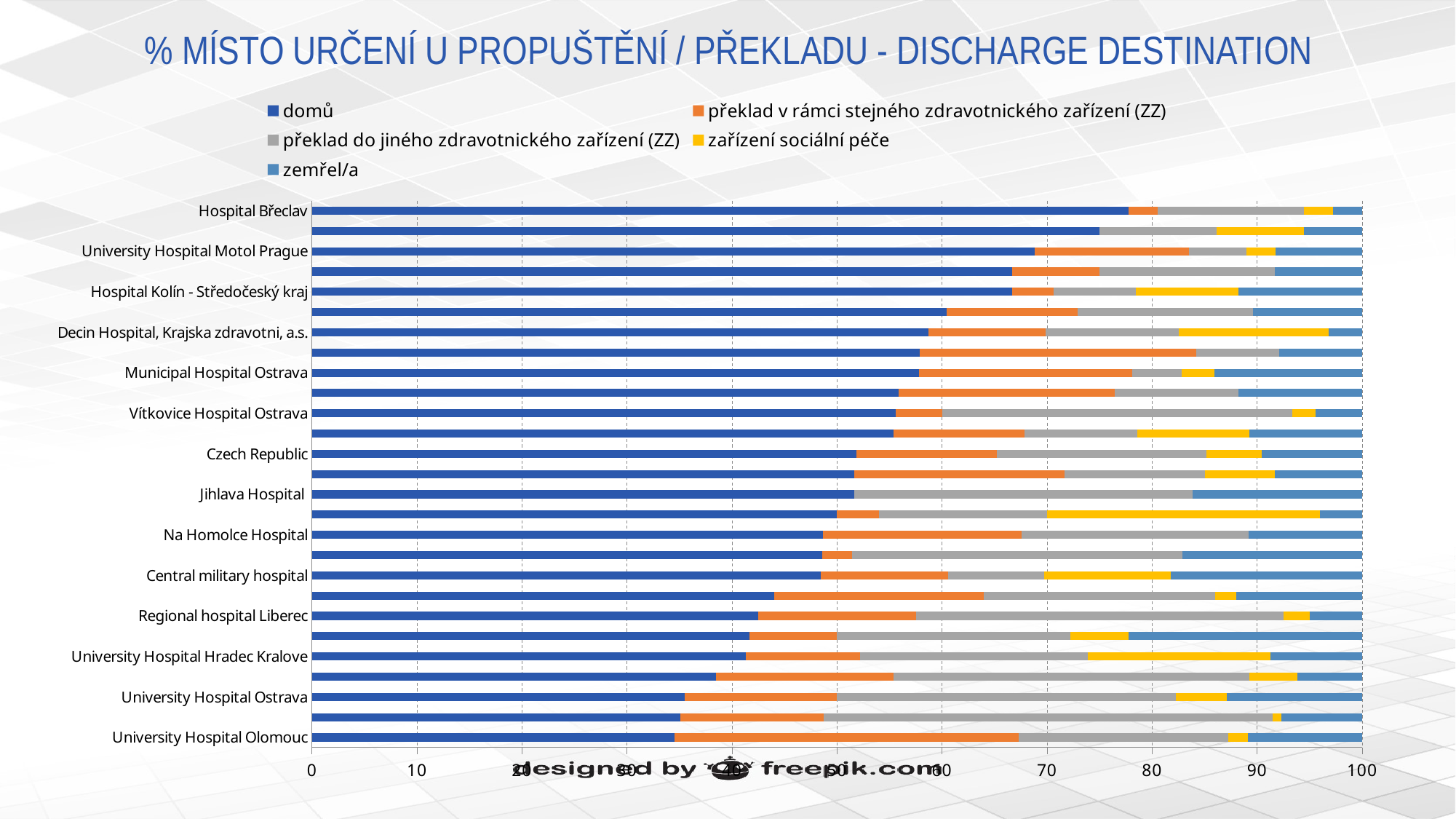
Is the 'domů' value for University Hospital Olomouc greater or less than 40? less What is the title of the chart? % MÍSTO URČENÍ U PROPUŠTĚNÍ / PŘEKLADU - DISCHARGE DESTINATION How many series does the legend list? 5 What kind of chart is shown on the slide? stacked bar chart Is the 'domů' value for Hospital Kolín - Středočeský kraj greater or less than 60? greater Among the labelled hospitals, which has the highest 'domů' share? Hospital Břeclav Which colour represents 'zařízení sociální péče' in the legend? yellow Is the 'domů' value for Hospital Břeclav greater or less than 70? greater Does the 'domů' share rise or fall going from the top bar to the bottom bar? fall Which has a larger 'domů' share, Hospital Břeclav or University Hospital Olomouc? Hospital Břeclav